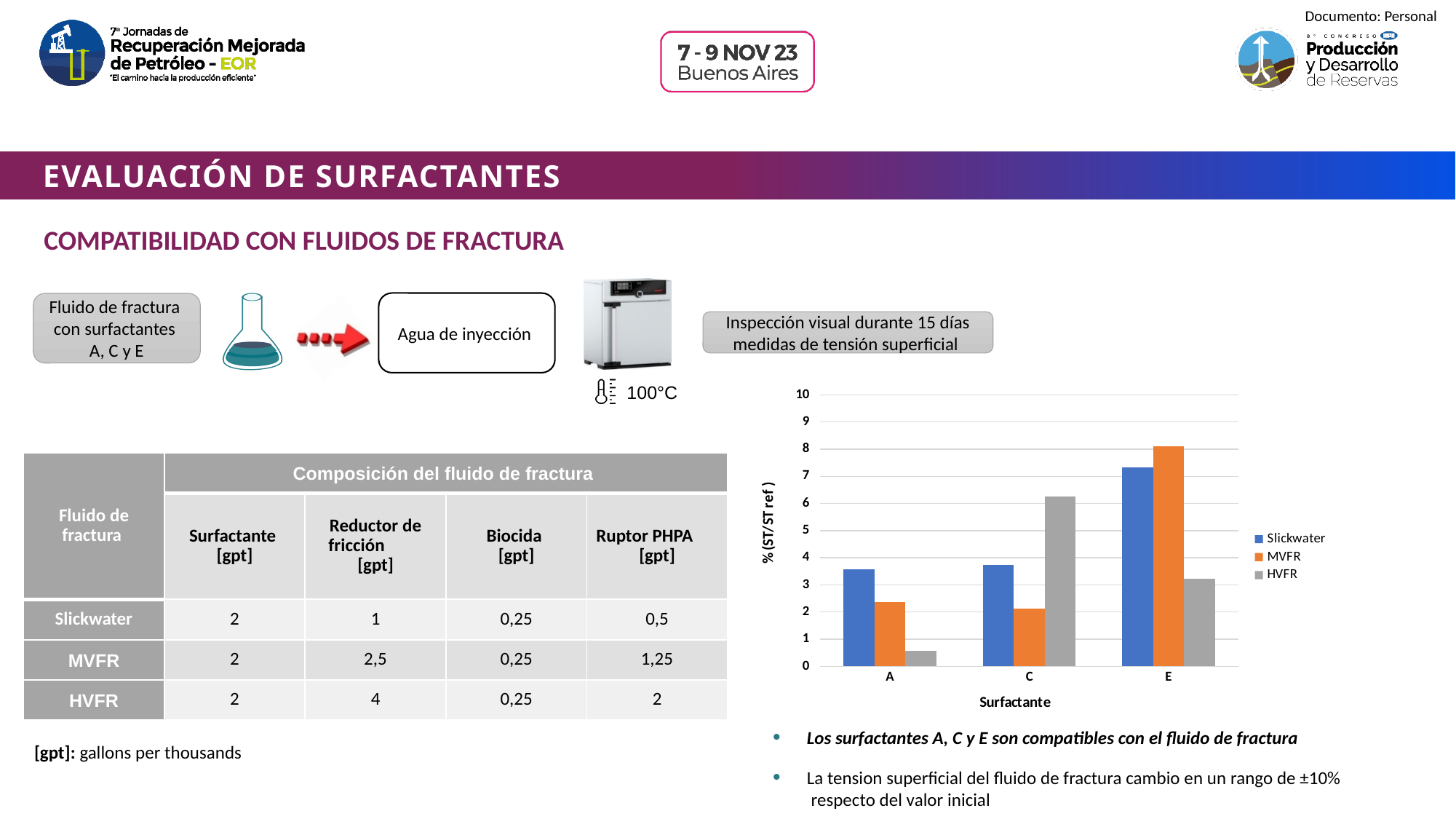
Is the MVFR value for surfactant E greater or less than 7? greater How many series does the chart legend list? 3 For surfactant E, which is larger: the MVFR value or the HVFR value? MVFR Is the HVFR value for surfactant C greater or less than 5? greater For which surfactant is the HVFR value lowest? A What is the label of the x axis of the chart? Surfactante For surfactant A, which series has the highest bar? Slickwater Is the Slickwater value for surfactant A greater or less than 4? less For which surfactant is the MVFR value highest? E What kind of chart is shown on the slide? bar chart How many surfactant categories are shown on the x axis of the chart? 3 For surfactant C, which is larger: the Slickwater value or the HVFR value? HVFR